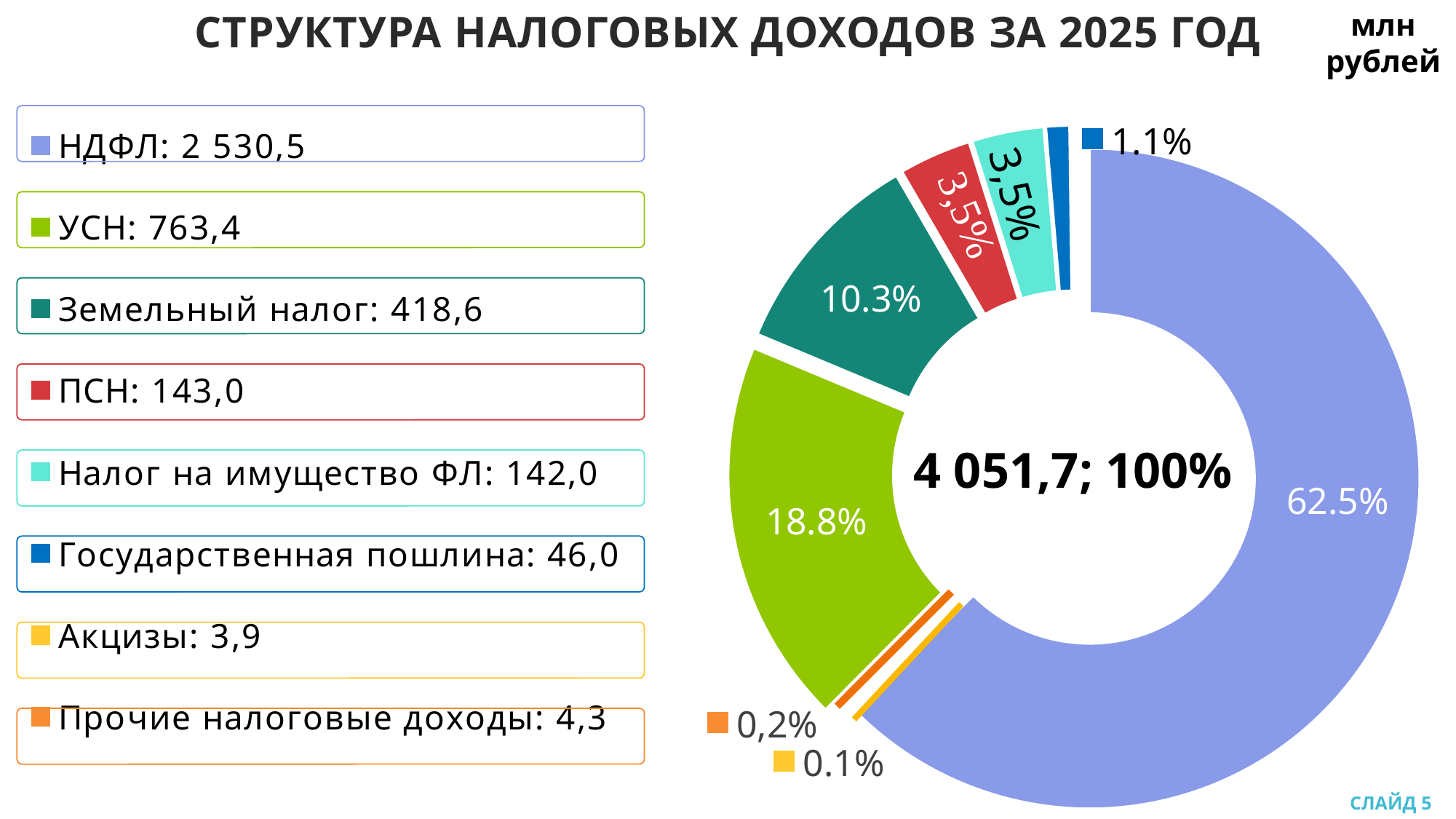
What type of chart is shown on the slide? Pie (donut) chart What share of the total does УСН represent? 18.8% What is the difference between УСН and Земельный налог? 344,8 Which is larger, Государственная пошлина or ПСН? ПСН What is the value for НДФЛ? 2 530,5 Which category has the highest value? НДФЛ What is the value for Государственная пошлина? 46,0 Which category has the lowest value? Акцизы What is the value for Земельный налог? 418,6 How many categories are shown in the chart? 8 What total value is shown in the centre of the chart? 4 051,7; 100% What share of the total does НДФЛ represent? 62.5%